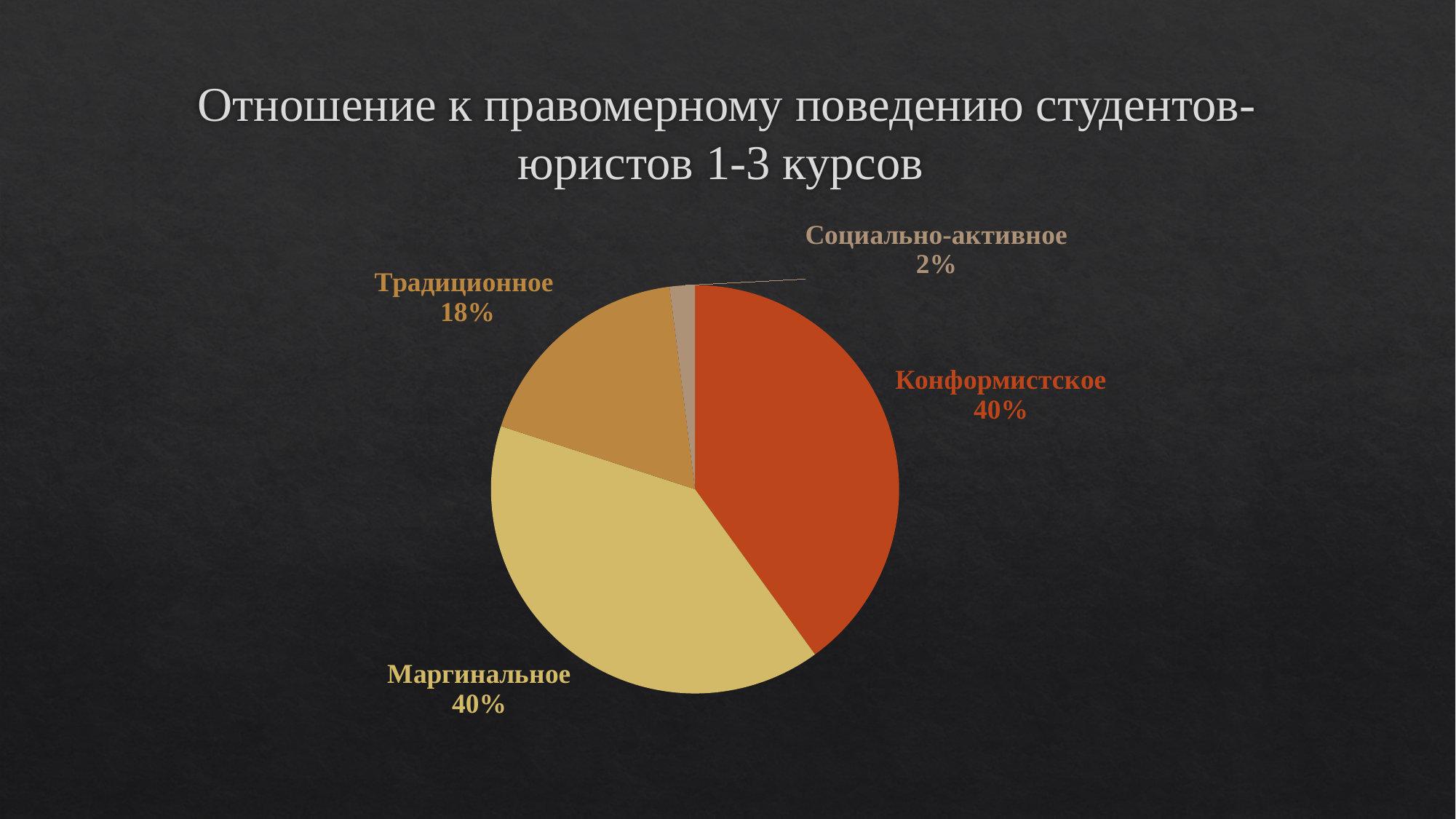
What is the title of the chart on the slide? Отношение к правомерному поведению студентов-юристов 1-3 курсов What kind of chart is shown on the slide? Pie chart What is the value shown for Традиционное? 18% What share of the pie does the Конформистское slice represent? 40% Which is larger, the Традиционное slice or the Социально-активное slice? Традиционное How many slices does the pie chart have? 4 Which category has the smallest slice of the pie? Социально-активное Which is larger, the Маргинальное slice or the Традиционное slice? Маргинальное What is the difference in percentage points between Конформистское and Традиционное? 22 What is the value shown for Социально-активное? 2% What is the difference in percentage points between Традиционное and Социально-активное? 16 What is the value shown for Маргинальное? 40%